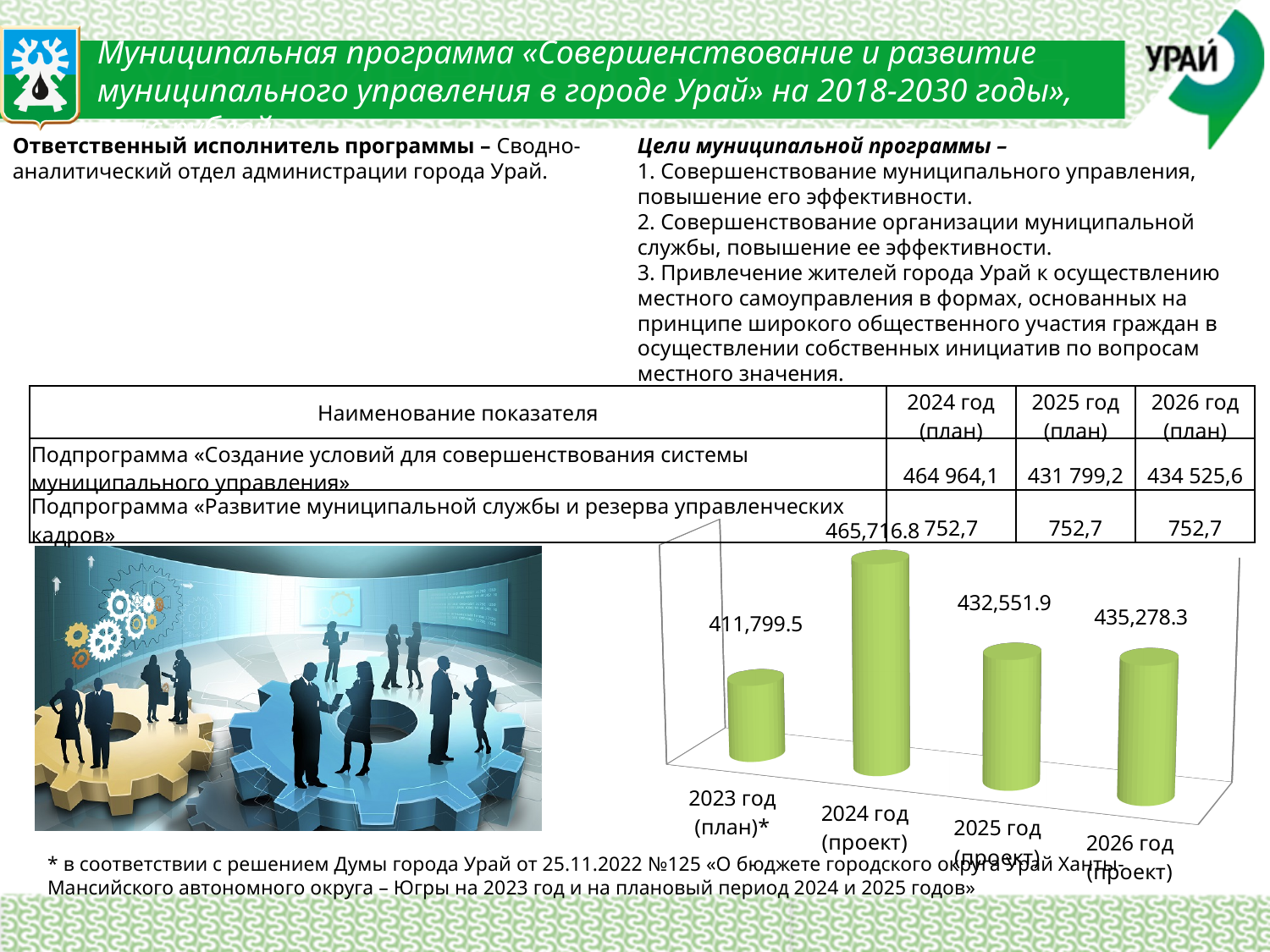
What kind of chart is shown on the slide? bar chart What colour are the bars in the chart? green Which is larger in the bar chart: the value for 2024 год (проект) or the value for 2025 год (проект)? 2024 год (проект) What is the value shown for 2025 год (проект) in the bar chart? 432,551.9 What is the value shown for 2024 год (проект) in the bar chart? 465,716.8 Which year has the highest value in the bar chart? 2024 год (проект) What is the difference between the values for 2026 год (проект) and 2025 год (проект) in the bar chart? 2,726.4 What is the value shown for 2026 год (проект) in the bar chart? 435,278.3 Which year has the lowest value in the bar chart? 2023 год (план)* How many categories (years) are plotted in the bar chart? 4 What is the difference between the values for 2024 год (проект) and 2023 год (план)* in the bar chart? 53,917.3 What is the value shown for 2023 год (план)* in the bar chart? 411,799.5